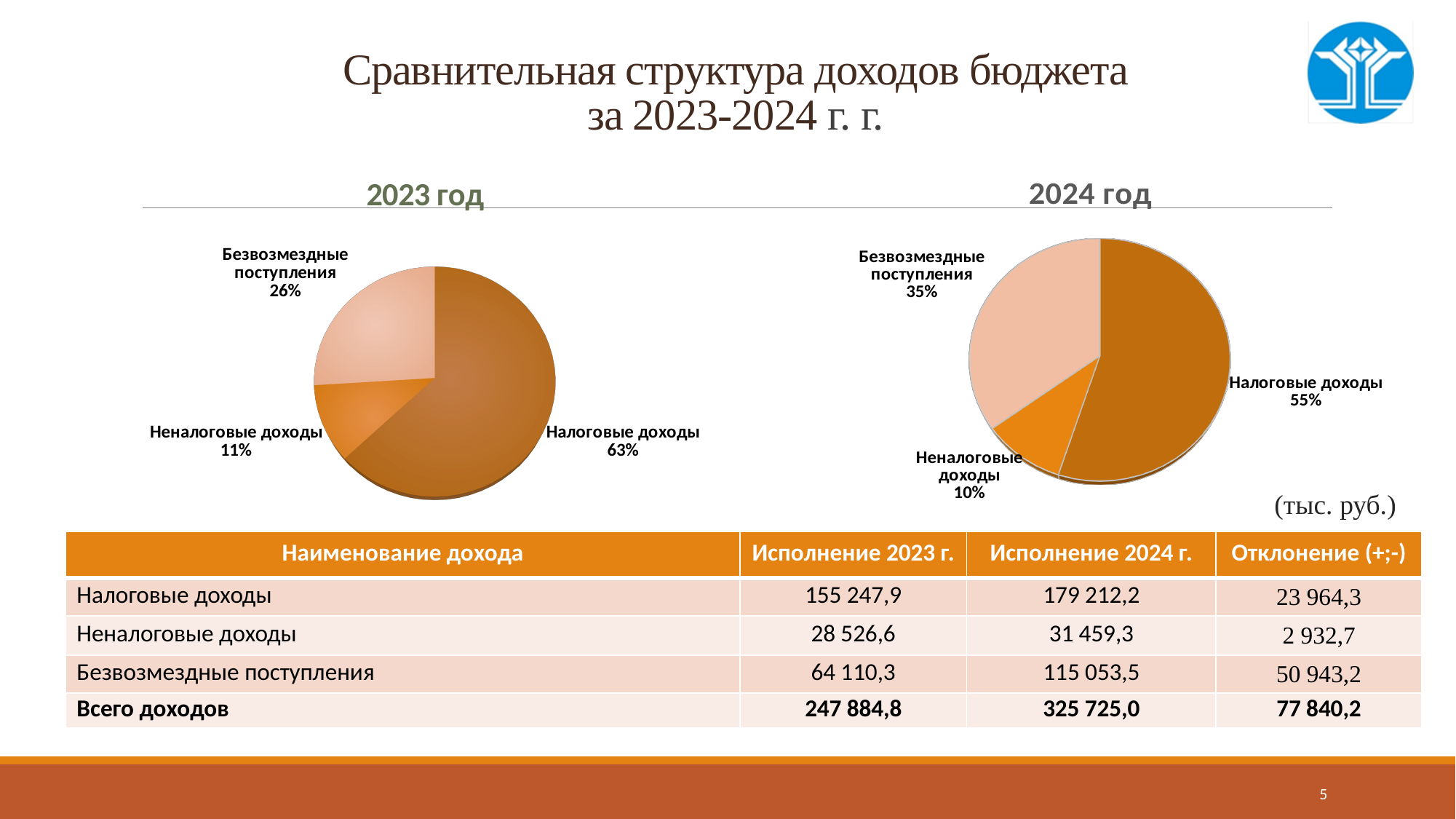
Which is larger: the share of Безвозмездные поступления in the 2023 год chart or in the 2024 год chart? 2024 год How many slices does the 2023 год pie chart have? 3 In the 2023 год pie chart, what share does Неналоговые доходы have? 11% In the 2024 год pie chart, which category has the smallest slice? Неналоговые доходы In the 2024 год pie chart, what share does Налоговые доходы have? 55% In the 2023 год pie chart, which category has the largest slice? Налоговые доходы In the 2023 год pie chart, what is the difference in percentage points between Налоговые доходы and Безвозмездные поступления? 37 percentage points What is the title of the left pie chart? 2023 год In the 2024 год pie chart, what share does Безвозмездные поступления have? 35% In the 2024 год pie chart, what is the difference in percentage points between Безвозмездные поступления and Неналоговые доходы? 25 percentage points What type of chart is used for 2024 год? Pie chart